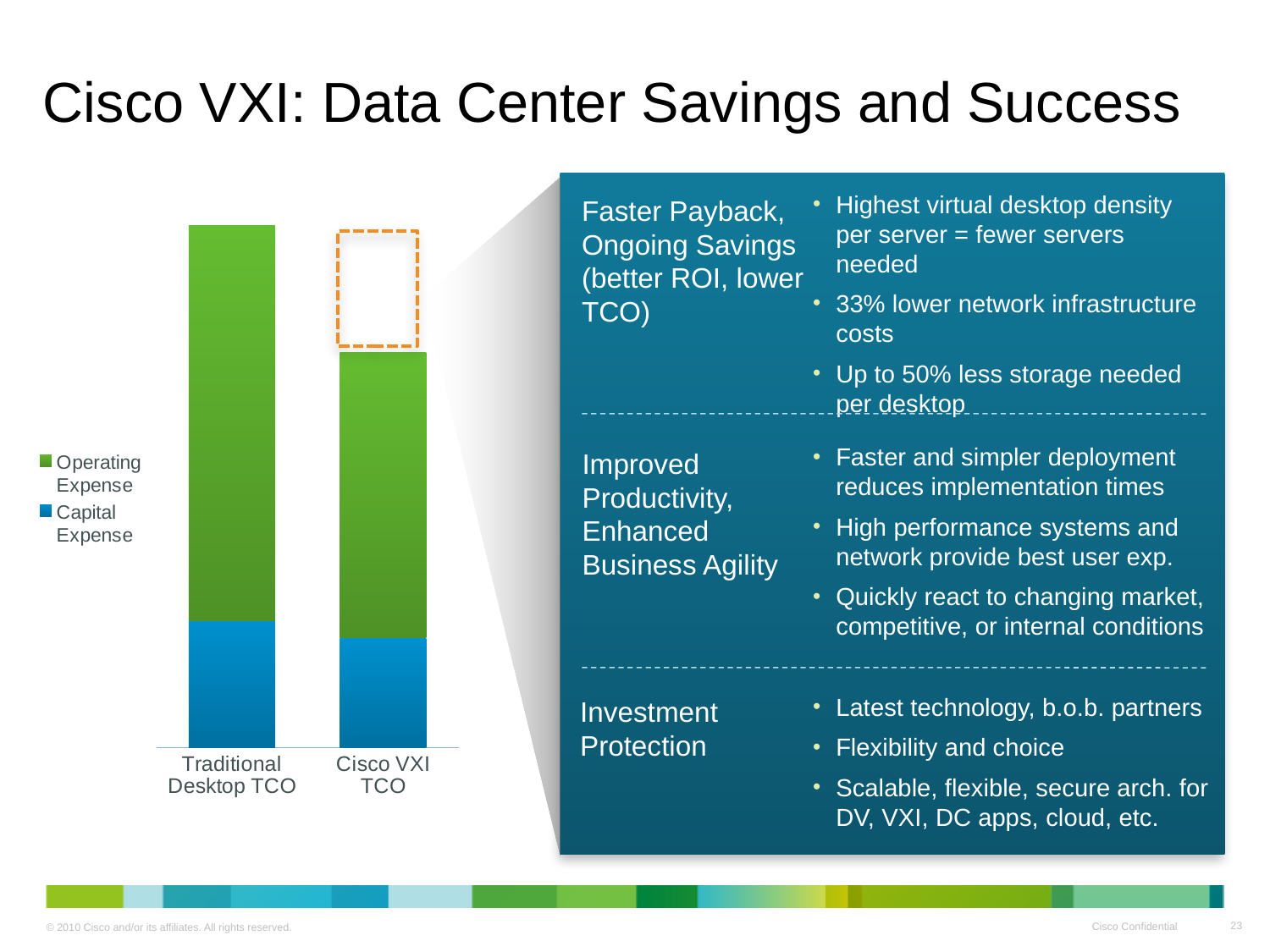
Do the total bar heights rise or fall from Traditional Desktop TCO to Cisco VXI TCO? Fall Which category has the lowest total bar in the chart? Cisco VXI TCO How many series does the legend of the bar chart list? 2 Which series is shown in green in the bar chart? Operating Expense Which category has the highest total bar in the chart? Traditional Desktop TCO Which category has the taller total bar, Traditional Desktop TCO or Cisco VXI TCO? Traditional Desktop TCO Which series is shown in blue in the bar chart? Capital Expense Is the Operating Expense segment larger for Traditional Desktop TCO or for Cisco VXI TCO? Traditional Desktop TCO What are the two category labels on the x axis of the bar chart? Traditional Desktop TCO and Cisco VXI TCO What kind of chart is shown on the left of the slide? Stacked bar chart How many categories are plotted on the x axis of the bar chart? 2 Is the Capital Expense segment larger for Traditional Desktop TCO or for Cisco VXI TCO? Traditional Desktop TCO